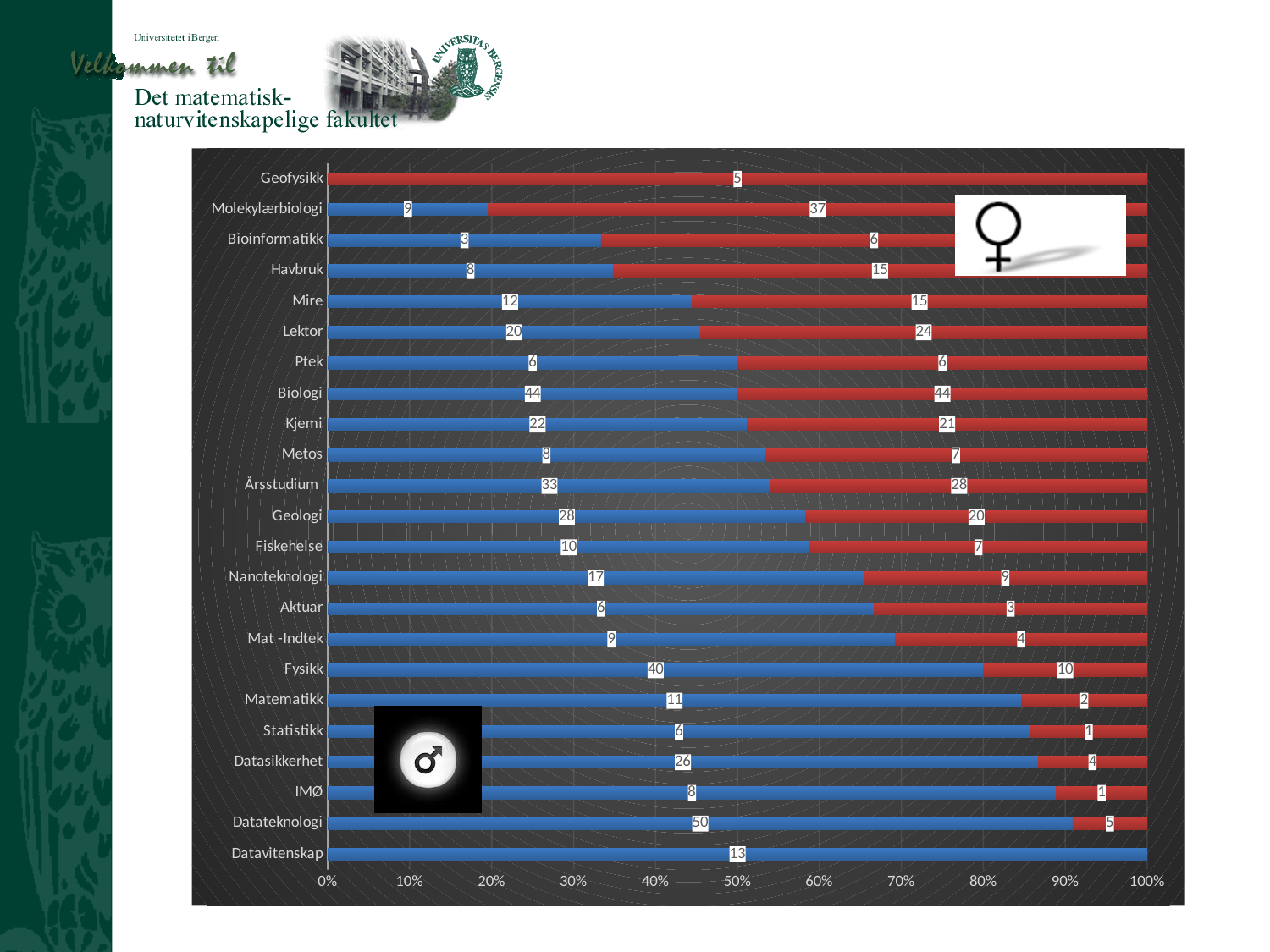
How many categories are shown on the chart? 23 Which is larger for Geologi, the blue value or the red value? blue Is the blue segment for Fysikk greater or less than 70% of the bar? greater What is the total of the blue and red values for Biologi? 88 What kind of chart is shown on the slide? stacked bar chart What is the value of the blue segment for Datateknologi? 50 What is the value of the red segment for Lektor? 24 What is the value of the red segment for Molekylærbiologi? 37 What is the value of the blue segment for Fysikk? 40 Is the blue segment for Molekylærbiologi greater or less than 30% of the bar? less What is the difference between the blue and red values for Fysikk? 30 What is the total of the blue and red values for Datateknologi? 55